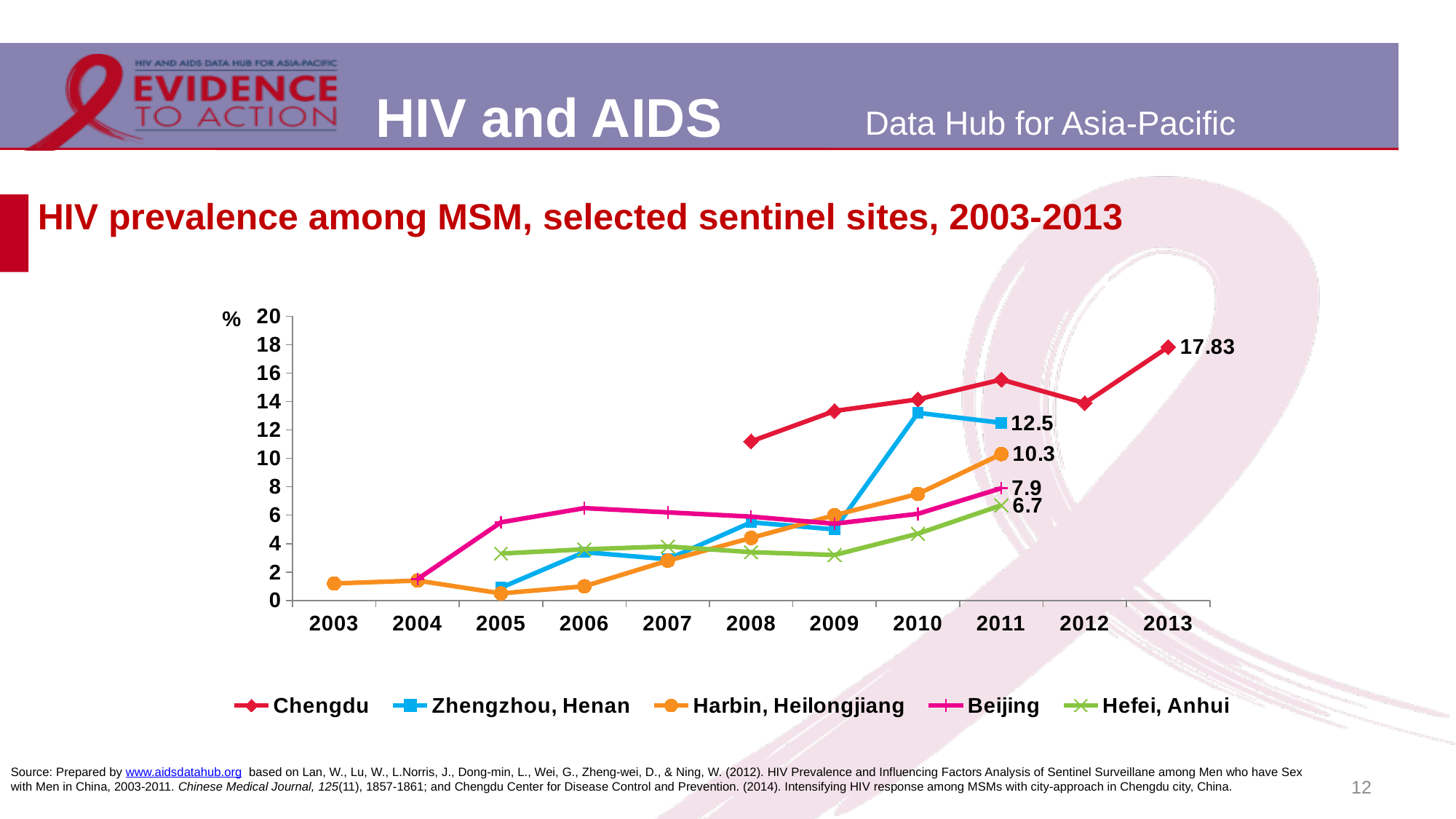
Which site has the highest value in 2011? Chengdu What is the difference between the 2011 values for Beijing and Hefei, Anhui? 1.2 What is the difference between the 2011 values for Zhengzhou, Henan and Harbin, Heilongjiang? 2.2 What is the value for Harbin, Heilongjiang in 2011? 10.3 Is the value for Chengdu in 2008 greater or less than 10? greater What is the value for Zhengzhou, Henan in 2011? 12.5 What is the value for Hefei, Anhui in 2011? 6.7 How many series does the legend list? 5 What is the HIV prevalence for Chengdu in 2013? 17.83 How many years are shown on the x axis? 11 What kind of chart is shown on the slide? line chart Which has the higher value in 2011, Harbin, Heilongjiang or Beijing? Harbin, Heilongjiang